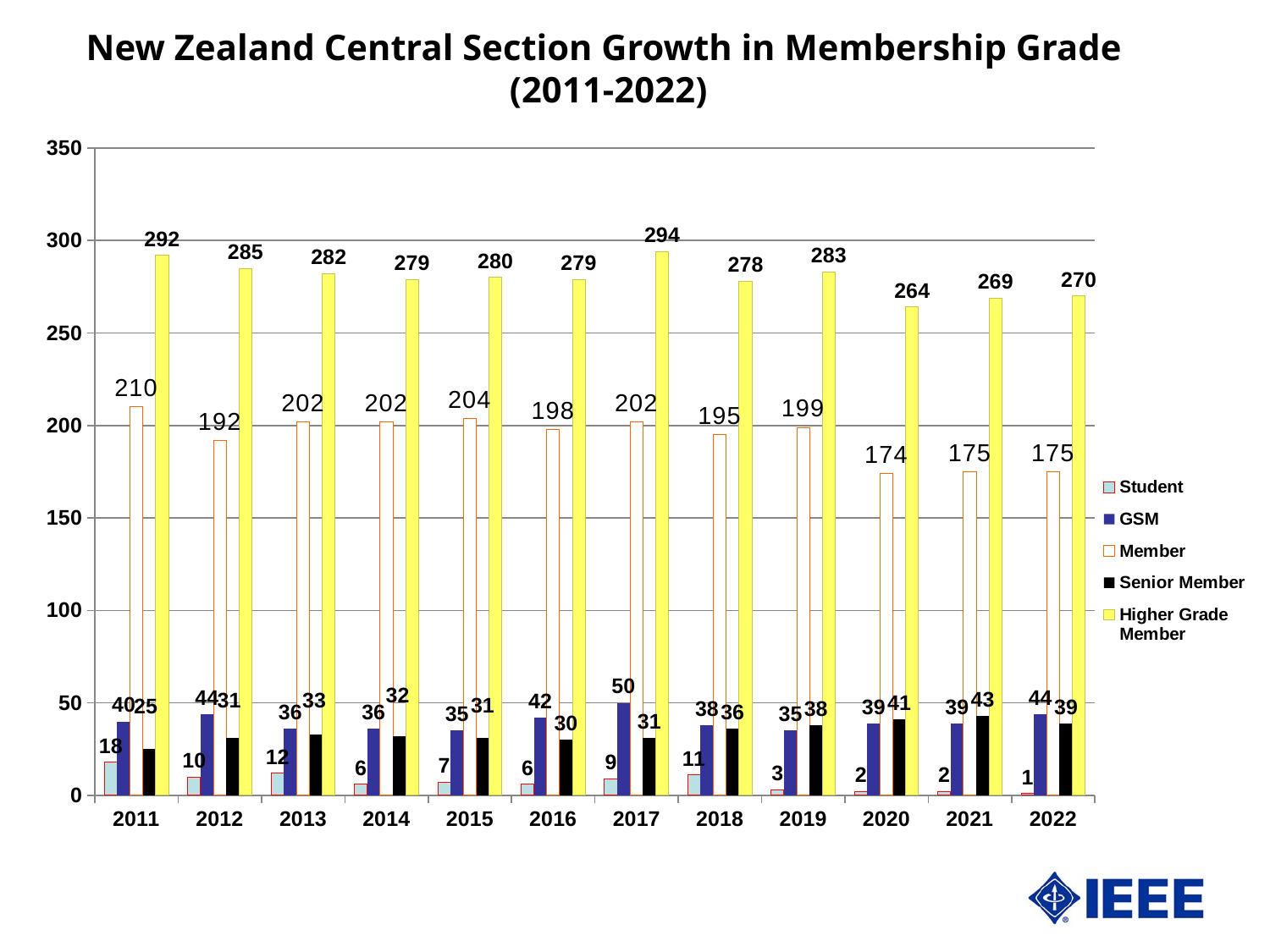
Which colour represents the Higher Grade Member series? yellow What kind of chart is shown on the slide? bar chart Is the Member value for 2016 greater or less than 150? greater What is the Higher Grade Member value for 2017? 294 In which year is the Higher Grade Member value lowest? 2020 Which is larger in 2019: the GSM value or the Senior Member value? Senior Member What is the Member value for 2020? 174 How many years are shown on the x axis? 12 How many series does the legend list? 5 What is the difference between the Member values for 2011 and 2022? 35 In which year is the GSM value highest? 2017 What is the Student value for 2011? 18